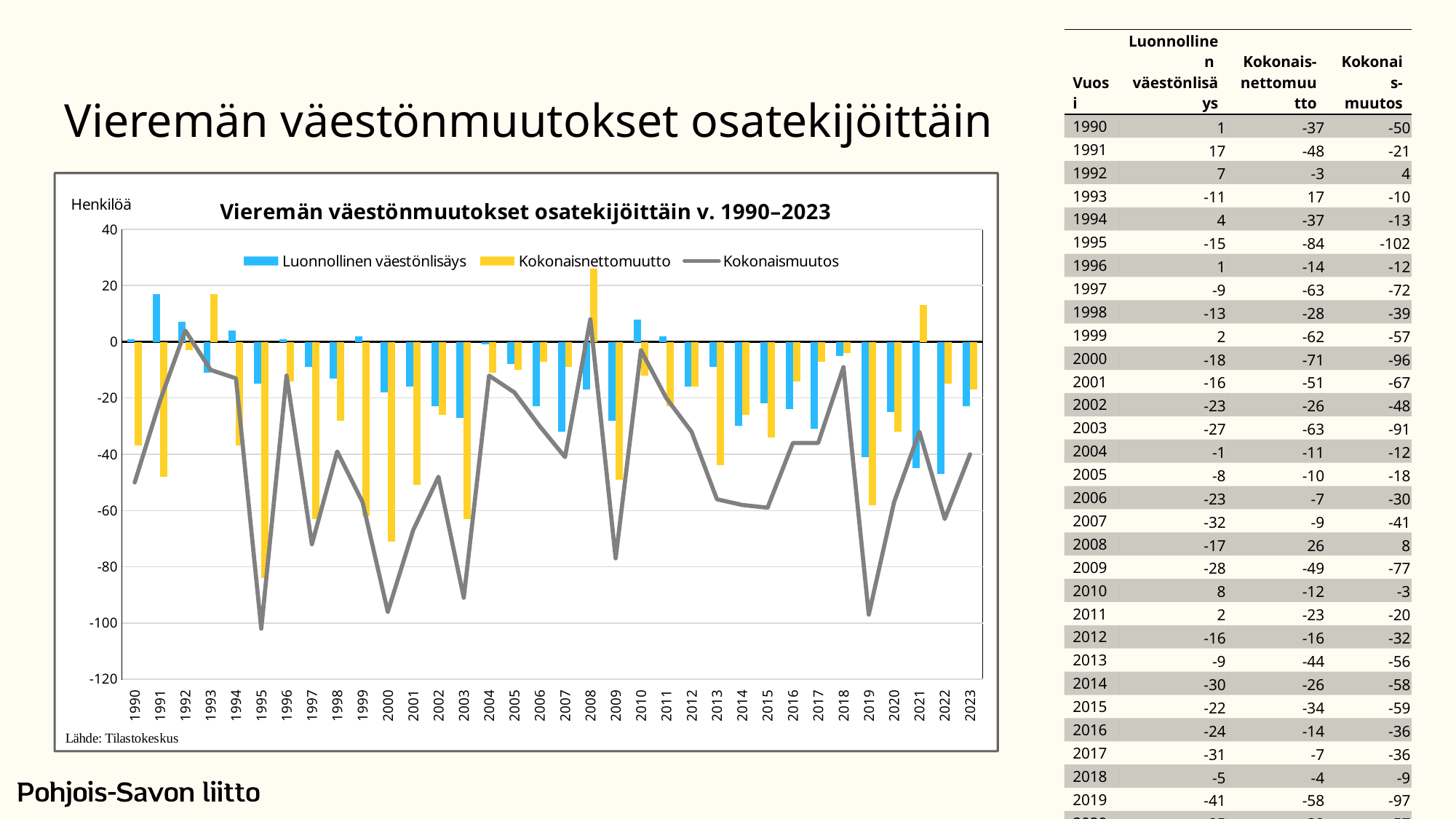
What is the value of Luonnollinen väestönlisäys in 2019? -41 Is the value of Kokonaismuutos in 2021 greater or less than -20? less What is the value of Kokonaisnettomuutto in 1995? -84 Which is larger, Kokonaismuutos in 1995 or in 2000? 2000 How many series does the chart legend list? 3 What kind of chart is shown on the slide? Bar and line chart What is the value of Kokonaismuutos in 2008? 8 What is the difference between Kokonaisnettomuutto in 1990 and in 1995? 47 How many years are plotted along the x axis of the chart? 34 Which colour represents Kokonaisnettomuutto in the chart? Yellow In which year is Kokonaismuutos at its lowest? 1995 In which year is Kokonaisnettomuutto at its highest? 2008